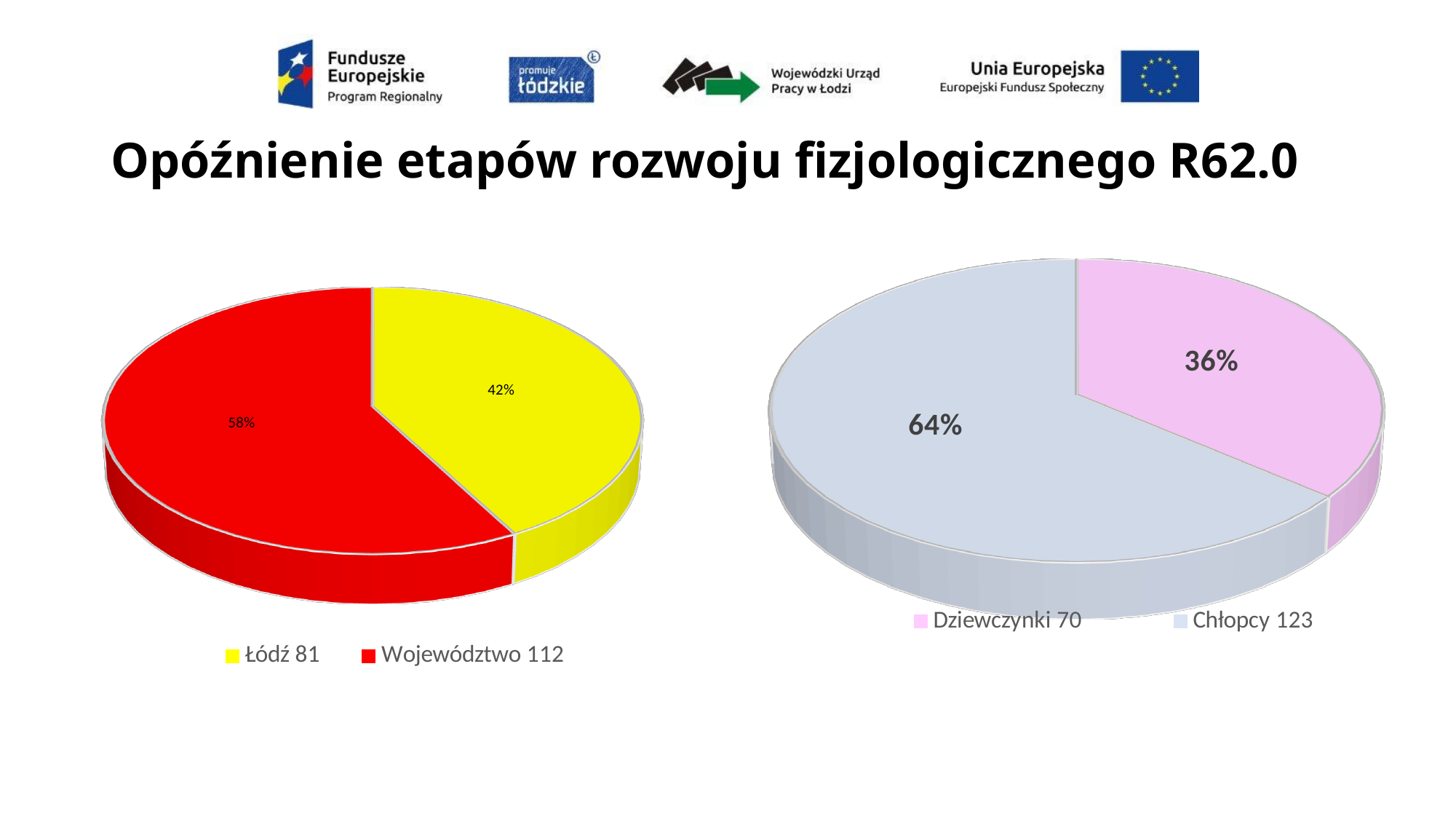
In the right pie chart, what value is shown for Chłopcy in the legend? 123 In the left pie chart, what value is shown for Łódź in the legend? 81 What type of chart is shown on the left of the slide? Pie chart In the right pie chart, which category has the smallest slice? Dziewczynki In the right pie chart, what percentage share does the Chłopcy slice have? 64% In the left pie chart, what percentage share does the Łódź slice have? 42% In the left pie chart, which slice is larger, Łódź or Województwo? Województwo In the left pie chart, what percentage share does the Województwo slice have? 58% In the right pie chart, what is the difference between the Chłopcy value and the Dziewczynki value? 53 In the left pie chart, what is the difference between the Województwo value and the Łódź value? 31 In the left pie chart, what value is shown for Województwo in the legend? 112